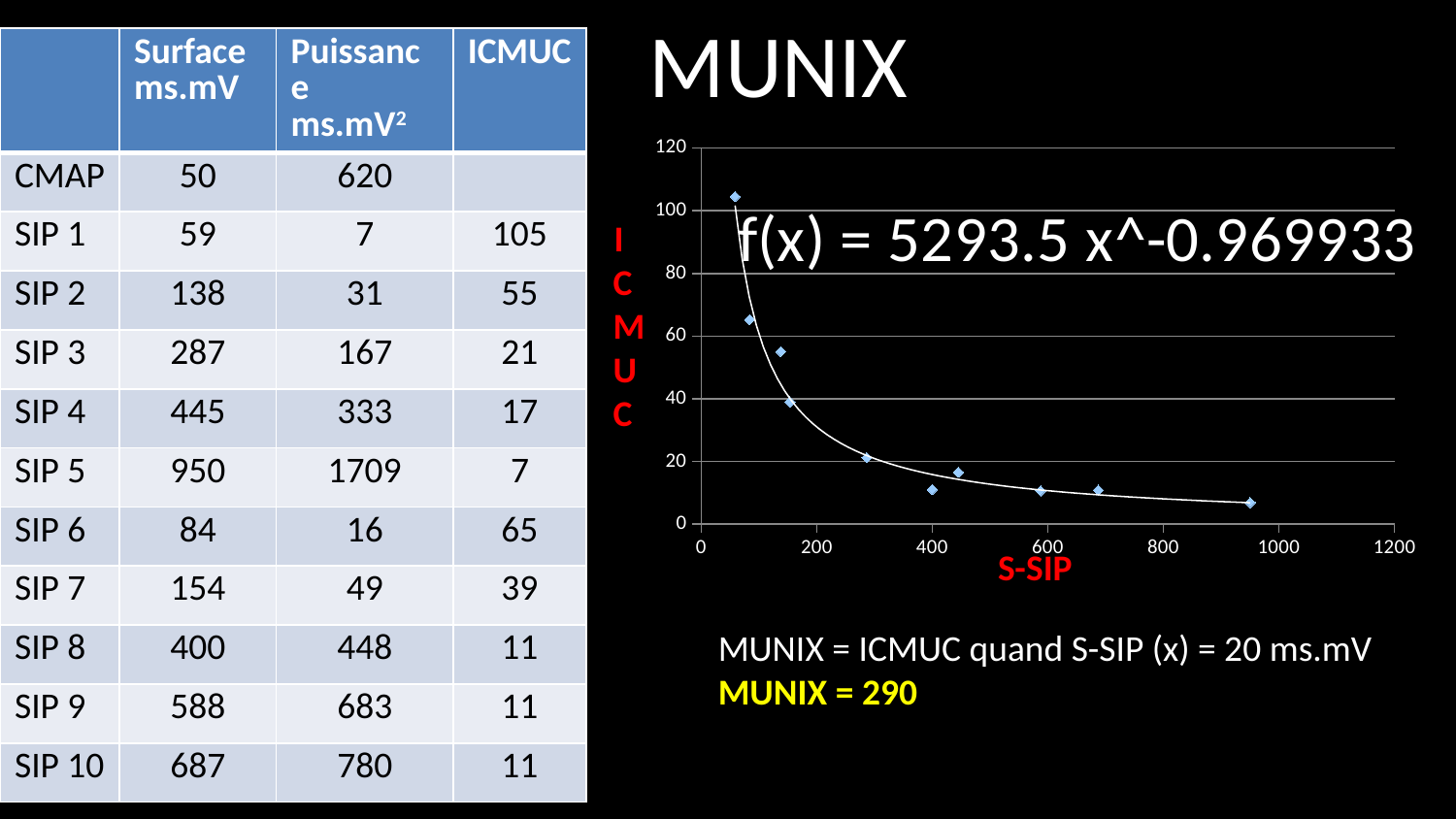
What is the highest tick value shown on the x axis? 1200 Is the ICMUC value of the point near S-SIP 400 greater or less than 20? less How many data points are plotted on the chart? 10 Is the ICMUC value of the rightmost point (near S-SIP 950) greater or less than 20? less Is the ICMUC value of the point near S-SIP 150 greater or less than 60? less What kind of chart is shown on the slide? scatter chart What is the label of the x axis of the chart? S-SIP Which point has the highest ICMUC value: the one with the smallest S-SIP or the one with the largest S-SIP? the one with the smallest S-SIP As S-SIP increases along the x axis, do the ICMUC values rise or fall? fall What is the trendline equation displayed on the chart? f(x) = 5293.5 x^-0.969933 What is the highest tick value shown on the y axis? 120